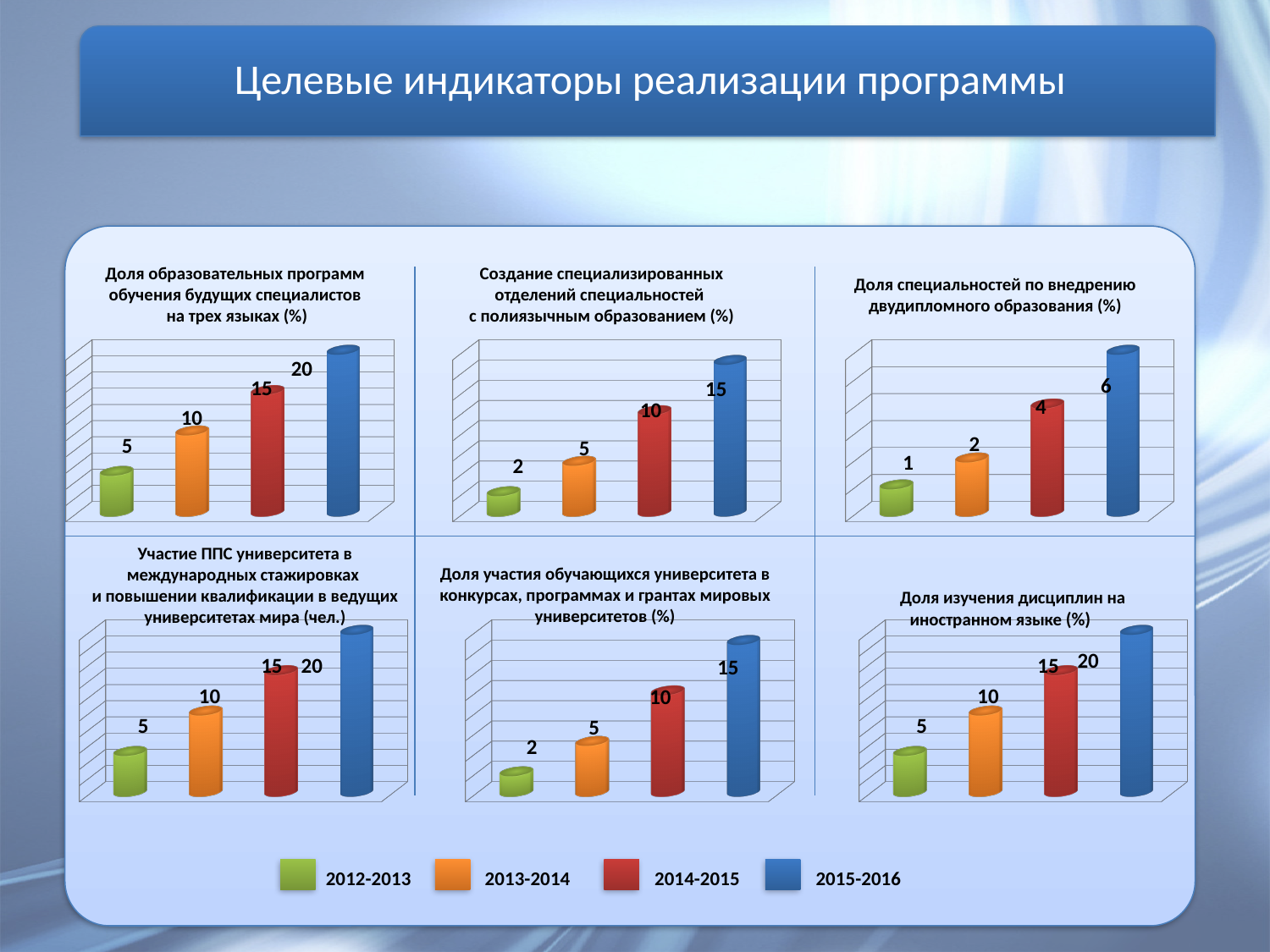
How many series does the legend at the bottom of the slide list? 4 How many bars are plotted in the bottom-right chart (Доля изучения дисциплин на иностранном языке)? 4 In the top-right chart (Доля специальностей по внедрению двудипломного образования), what is the value for 2014-2015? 4 In the top-middle chart (Создание специализированных отделений специальностей с полиязычным образованием), what is the value for 2012-2013? 2 In the top-left chart (Доля образовательных программ обучения будущих специалистов на трех языках), what is the value for 2015-2016? 20 In the bottom-left chart (Участие ППС университета в международных стажировках), what is the difference between the 2015-2016 and 2013-2014 values? 10 In the bottom-middle chart (Доля участия обучающихся университета в конкурсах, программах и грантах мировых университетов), which period has the lowest value? 2012-2013 Which colour represents the 2014-2015 series in the legend? Red In the top-middle chart (Создание специализированных отделений специальностей с полиязычным образованием), which is larger: the value for 2013-2014 or for 2014-2015? 2014-2015 What kind of chart is the bottom-right chart (Доля изучения дисциплин на иностранном языке)? Bar chart In the top-right chart (Доля специальностей по внедрению двудипломного образования), which period has the highest value? 2015-2016 In the top-right chart (Доля специальностей по внедрению двудипломного образования), do the values rise or fall from 2012-2013 to 2015-2016? Rise